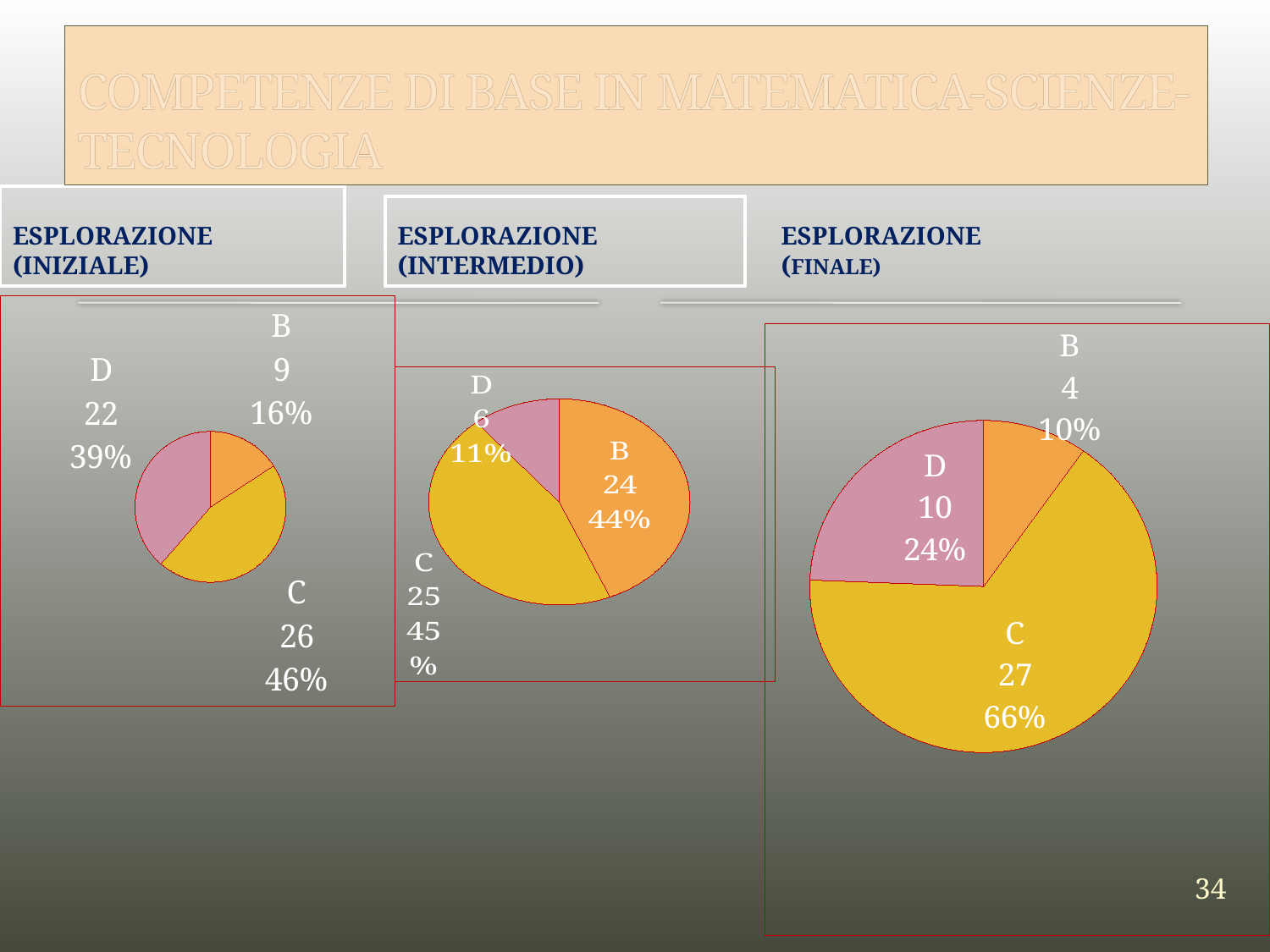
In the ESPLORAZIONE (INIZIALE) pie chart, which category has the smallest value? B What type of chart is used under ESPLORAZIONE (INTERMEDIO)? Pie chart In the ESPLORAZIONE (INTERMEDIO) pie chart, what is the value for category B? 24 In the ESPLORAZIONE (INTERMEDIO) pie chart, what percentage share does category D have? 11% In the ESPLORAZIONE (INIZIALE) pie chart, what is the value for category D? 22 In the ESPLORAZIONE (INIZIALE) pie chart, what percentage share does category C have? 46% In the ESPLORAZIONE (FINALE) pie chart, what percentage share does category B have? 10% In the ESPLORAZIONE (FINALE) pie chart, which is larger, the value for D or the value for B? D In the ESPLORAZIONE (INTERMEDIO) pie chart, what is the difference between the values for C and D? 19 How many slices does the ESPLORAZIONE (INIZIALE) pie chart have? 3 In the ESPLORAZIONE (FINALE) pie chart, which category has the largest value? C In the ESPLORAZIONE (FINALE) pie chart, what is the value for category C? 27